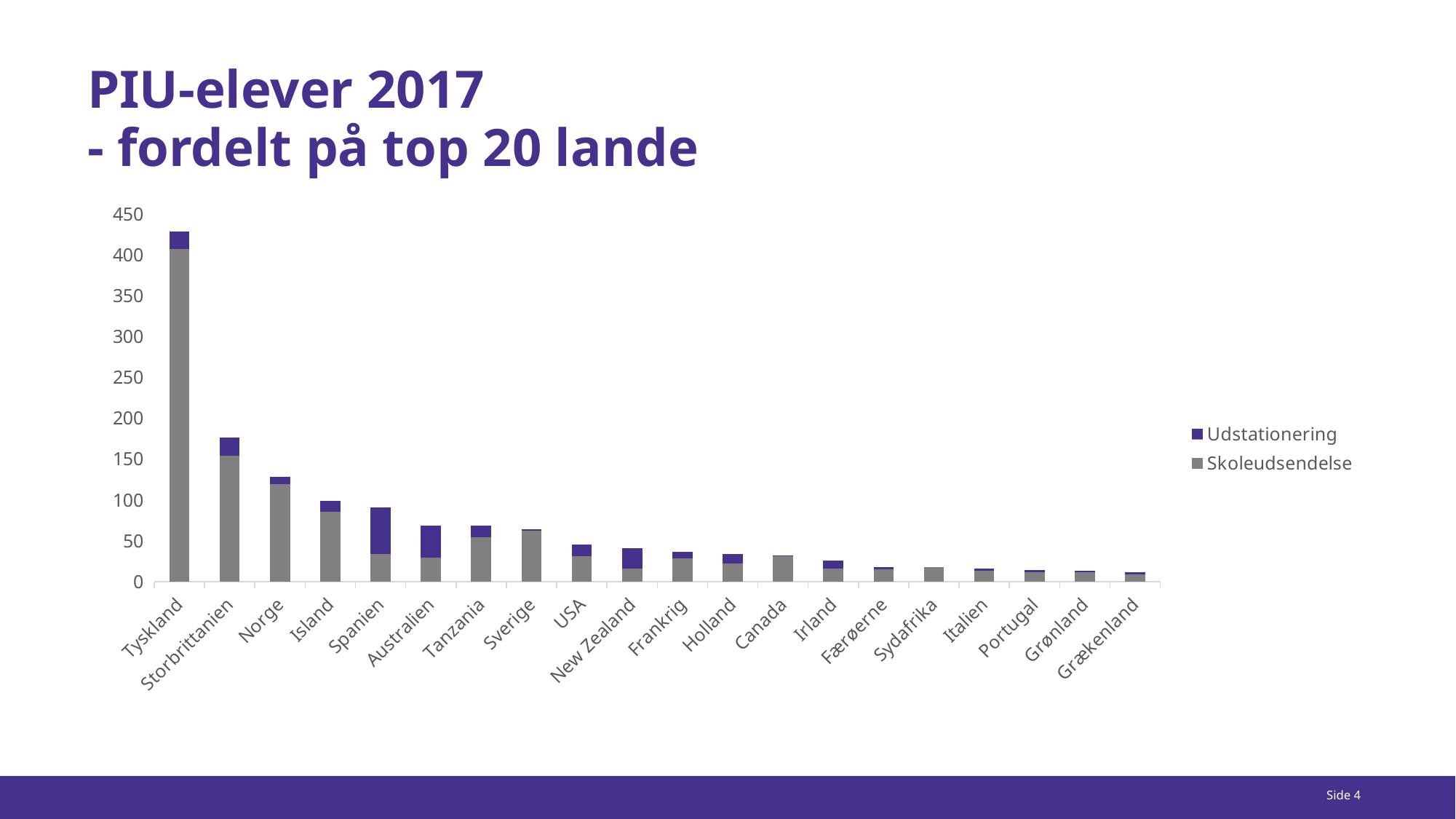
Is the total value for Tyskland greater or less than 400? greater Which country has the highest total bar in the chart? Tyskland Which country has the lowest total bar in the chart? Grækenland How many series does the chart's legend list? 2 Do the total bar values rise or fall moving from left to right along the x axis? Fall Is the total value for Storbrittanien greater or less than 150? greater How many countries are shown on the x axis of the chart? 20 Which series is shown in purple in the chart's legend? Udstationering What kind of chart is shown on the slide? Stacked bar chart Is the total value for Canada greater or less than 50? less Which has the larger total bar, Norge or Spanien? Norge